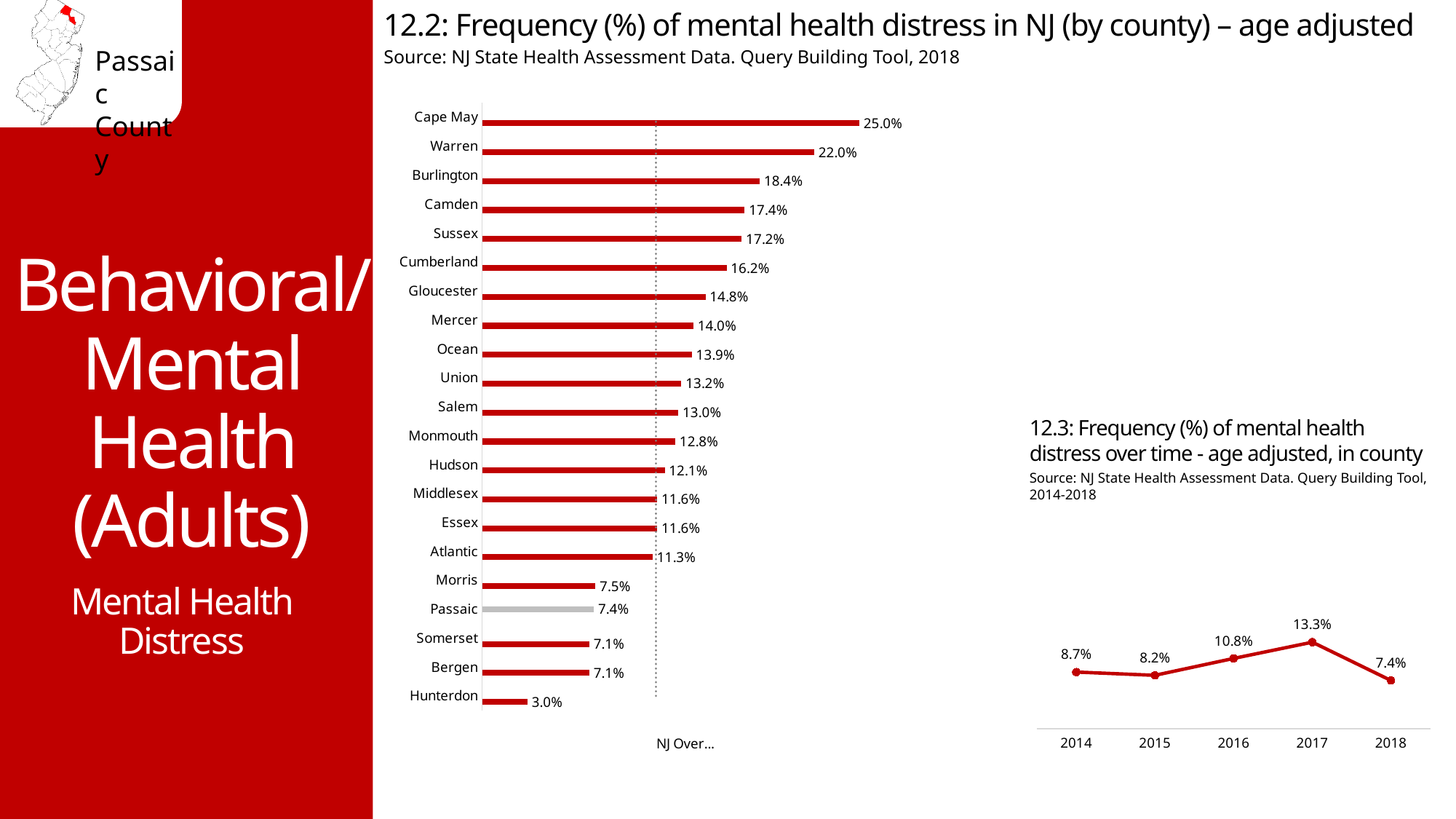
In the chart '12.2: Frequency (%) of mental health distress in NJ (by county) – age adjusted', which county has the lowest value? Hunterdon What kind of chart is '12.2: Frequency (%) of mental health distress in NJ (by county) – age adjusted'? Bar chart In the chart '12.2: Frequency (%) of mental health distress in NJ (by county) – age adjusted', what is the difference between Cape May and Warren? 3.0% In the chart '12.2: Frequency (%) of mental health distress in NJ (by county) – age adjusted', which is larger, Camden or Sussex? Camden In the chart '12.2: Frequency (%) of mental health distress in NJ (by county) – age adjusted', what is the value for Gloucester? 14.8% In the chart '12.3: Frequency (%) of mental health distress over time - age adjusted, in county', which year has the lowest value? 2018 In the chart '12.2: Frequency (%) of mental health distress in NJ (by county) – age adjusted', what is the value for Passaic? 7.4% In the chart '12.3: Frequency (%) of mental health distress over time - age adjusted, in county', what is the value for 2017? 13.3% In the chart '12.2: Frequency (%) of mental health distress in NJ (by county) – age adjusted', which county has the highest value? Cape May What kind of chart is '12.3: Frequency (%) of mental health distress over time - age adjusted, in county'? Line chart In the chart '12.2: Frequency (%) of mental health distress in NJ (by county) – age adjusted', how many counties are shown? 21 In the chart '12.3: Frequency (%) of mental health distress over time - age adjusted, in county', what is the difference between 2017 and 2018? 5.9%